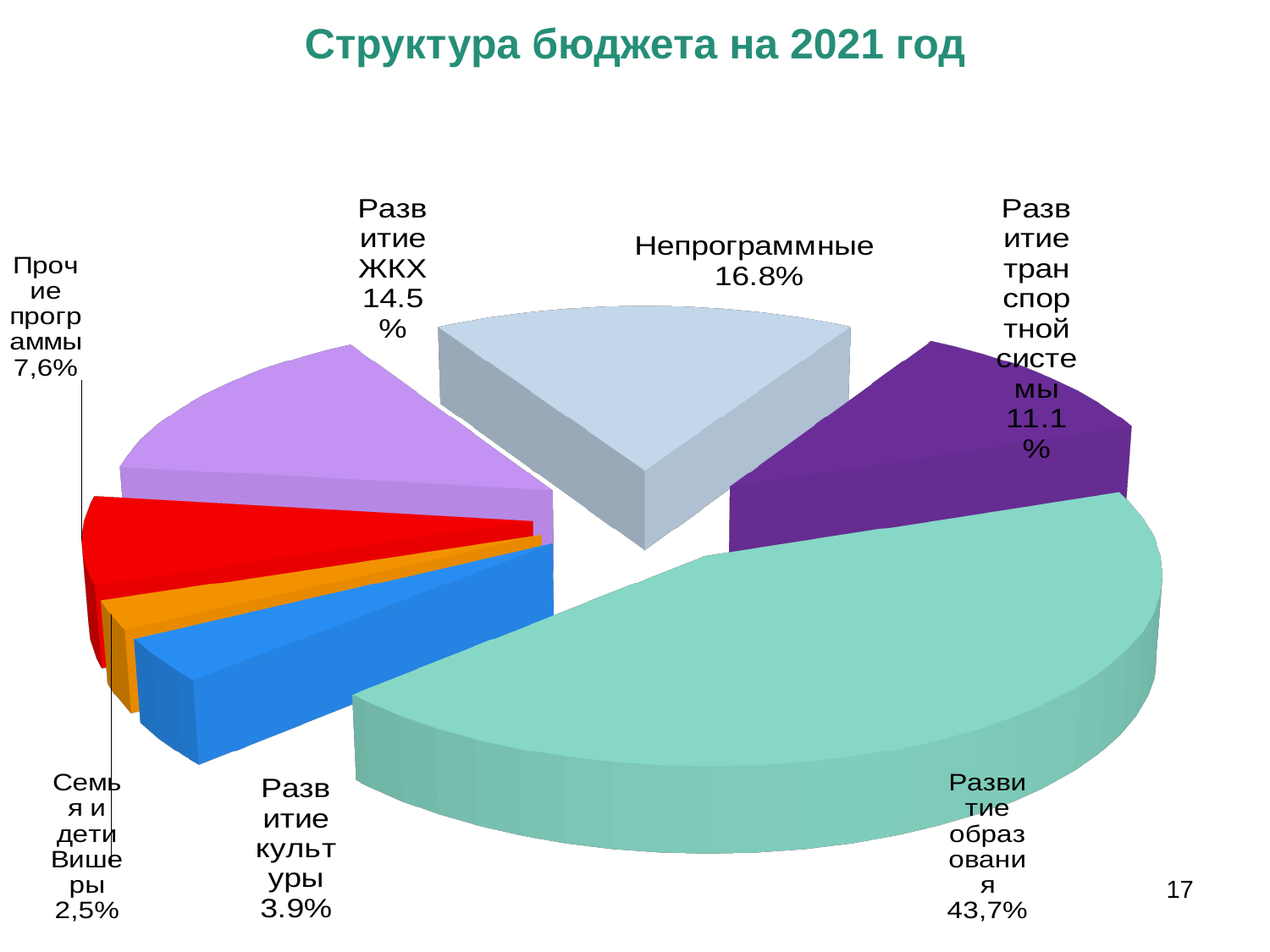
Which category has the largest share of the budget? Развитие образования What share of the budget goes to Развитие образования? 43,7% What percentage is shown for Семья и дети Вишеры? 2,5% What percentage is shown for Непрограммные? 16.8% How many slices does the pie chart have? 7 By how many percentage points does Непрограммные exceed Развитие ЖКХ? 2.3 What kind of chart is shown on the slide? Pie chart What is the title of the chart? Структура бюджета на 2021 год What percentage is shown for Развитие транспортной системы? 11.1% Which category has the smallest share of the budget? Семья и дети Вишеры Which is larger, the share for Прочие программы or the share for Развитие культуры? Прочие программы What percentage is shown for Развитие ЖКХ? 14.5%